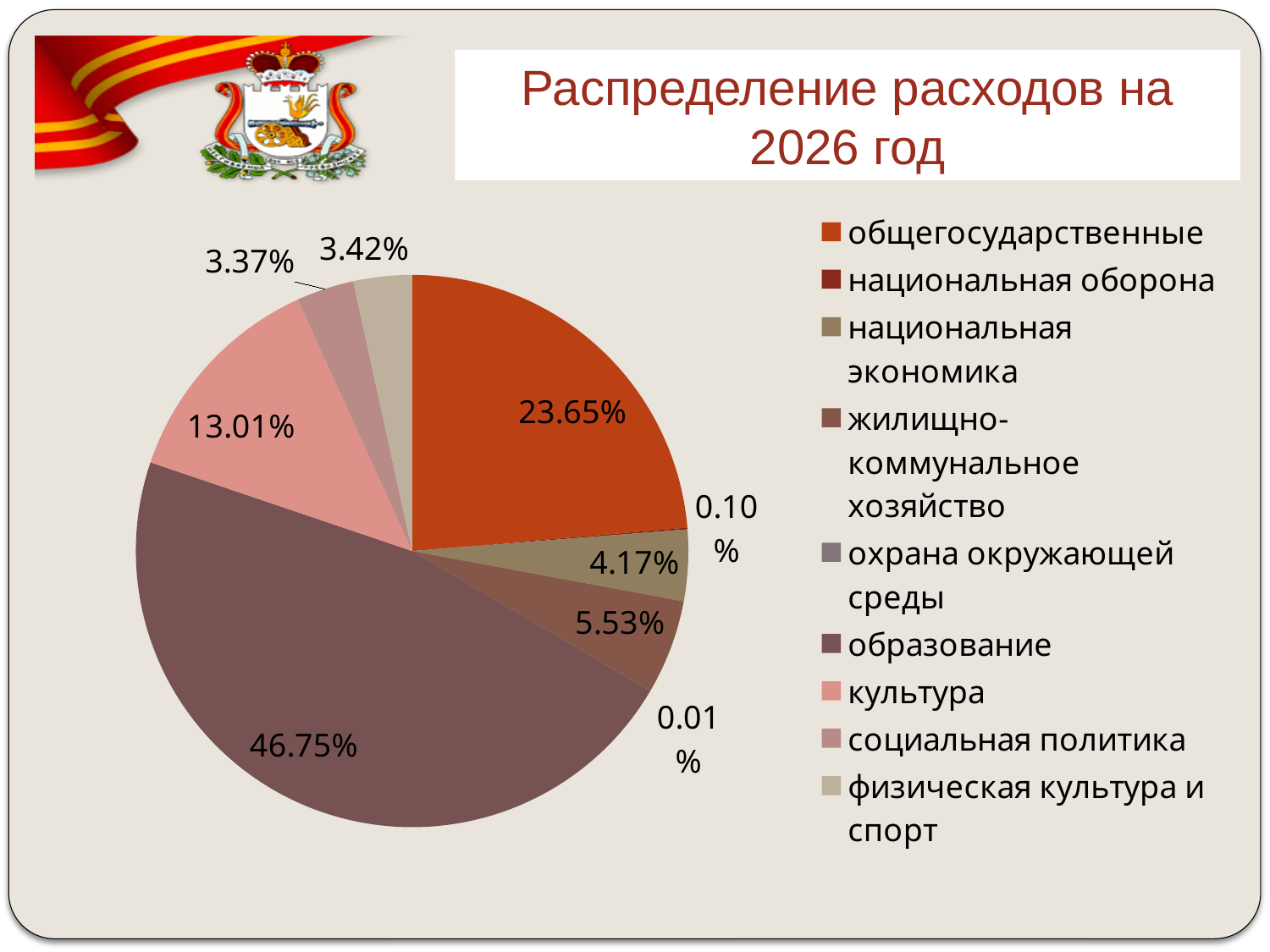
Which category has the largest share of expenditures? образование What kind of chart is shown on the slide? pie chart What is the title of the chart on the slide? Распределение расходов на 2026 год What share of expenditures goes to образование? 46.75% How many categories does the legend of the pie chart list? 9 What share of expenditures goes to жилищно-коммунальное хозяйство? 5.53% What share of expenditures goes to общегосударственные? 23.65% What is the difference between the shares for образование and общегосударственные? 23.10% What share of expenditures goes to национальная экономика? 4.17% What share of expenditures goes to культура? 13.01% Which category has the smallest share of expenditures? охрана окружающей среды Which is larger, the share for социальная политика or the share for физическая культура и спорт? физическая культура и спорт